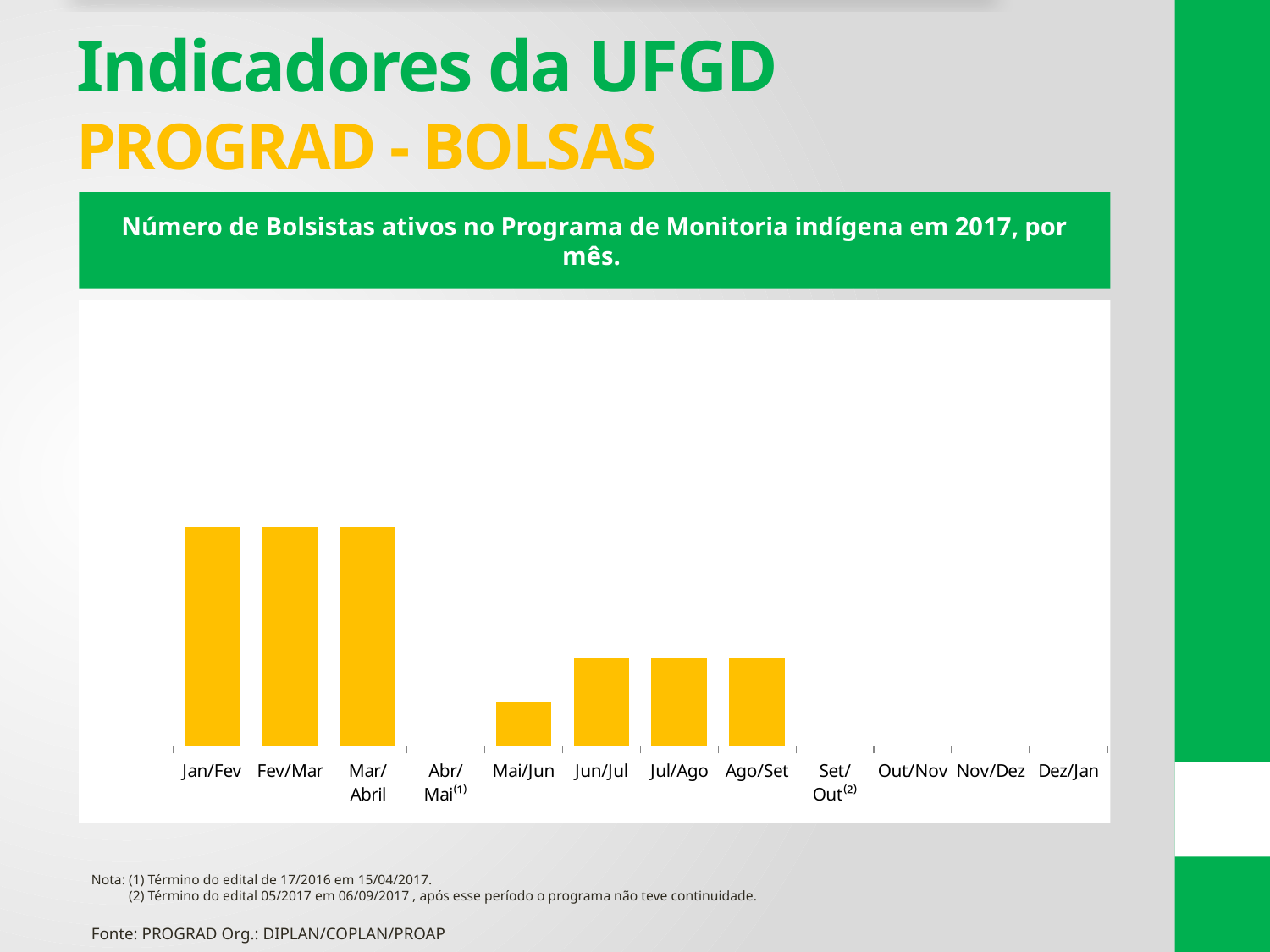
Which of the two is larger: the bar for Jan/Fev or the bar for Mai/Jun? Jan/Fev Which of the two is larger: the bar for Mar/Abril or the bar for Ago/Set? Mar/Abril Which of the two is larger: the bar for Mai/Jun or the bar for Jun/Jul? Jun/Jul How many categories are shown on the x axis of the chart? 12 What kind of chart is shown on the slide? bar chart What colour are the bars in the chart? yellow How many categories on the chart have a visible bar? 7 Do the bars rise or fall from Mai/Jun to Jun/Jul? rise What is the title of the chart? Número de Bolsistas ativos no Programa de Monitoria indígena em 2017, por mês. Does the chart show a bar for Out/Nov? No Does the chart show a bar for Abr/Mai? No Among the categories that have a visible bar, which one has the lowest bar? Mai/Jun